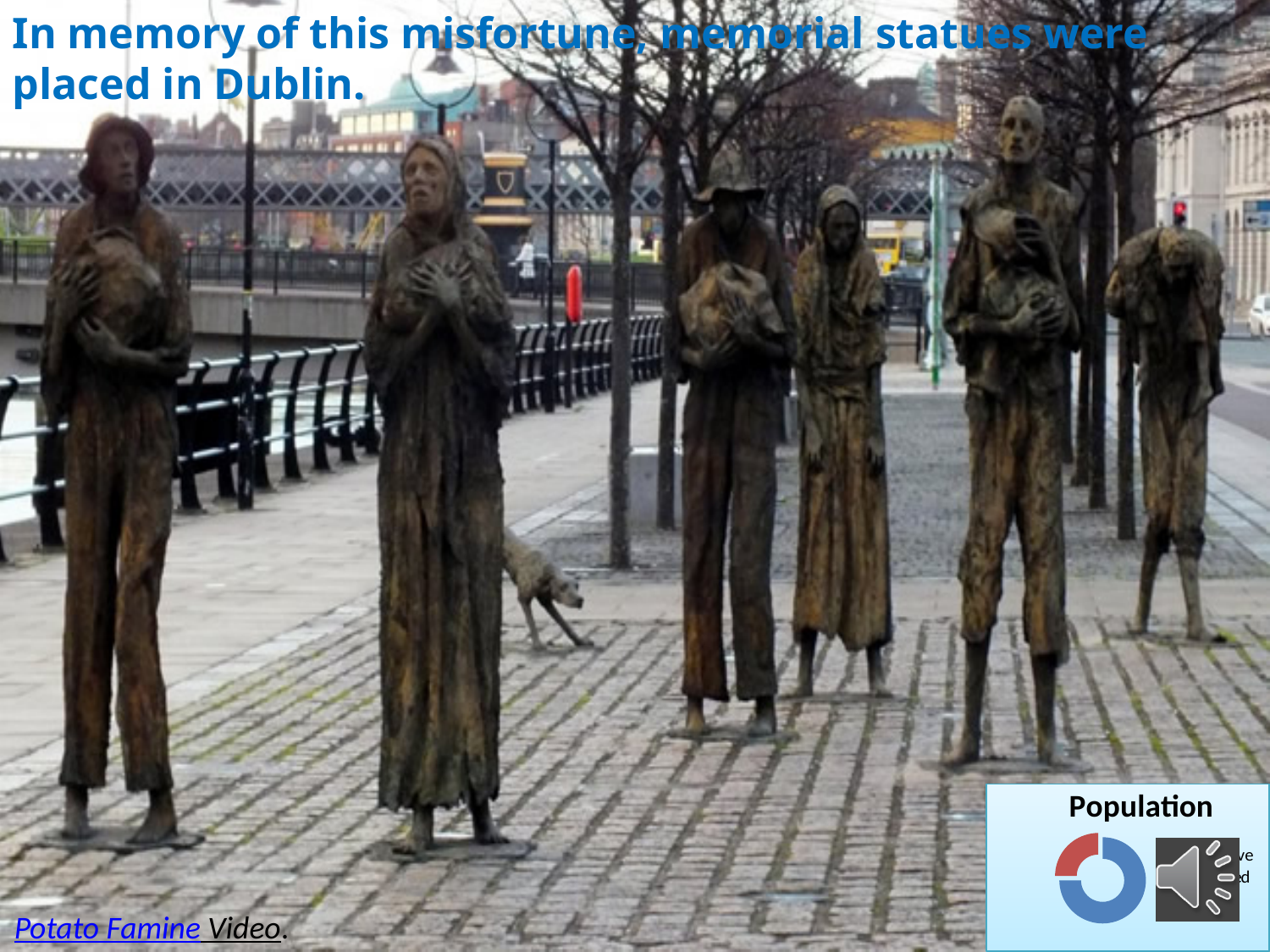
In the "Population" chart, which colour slice is larger, the blue one or the red one? blue What kind of chart is the "Population" chart on the slide? doughnut chart What is the title of the chart in the bottom-right corner of the slide? Population